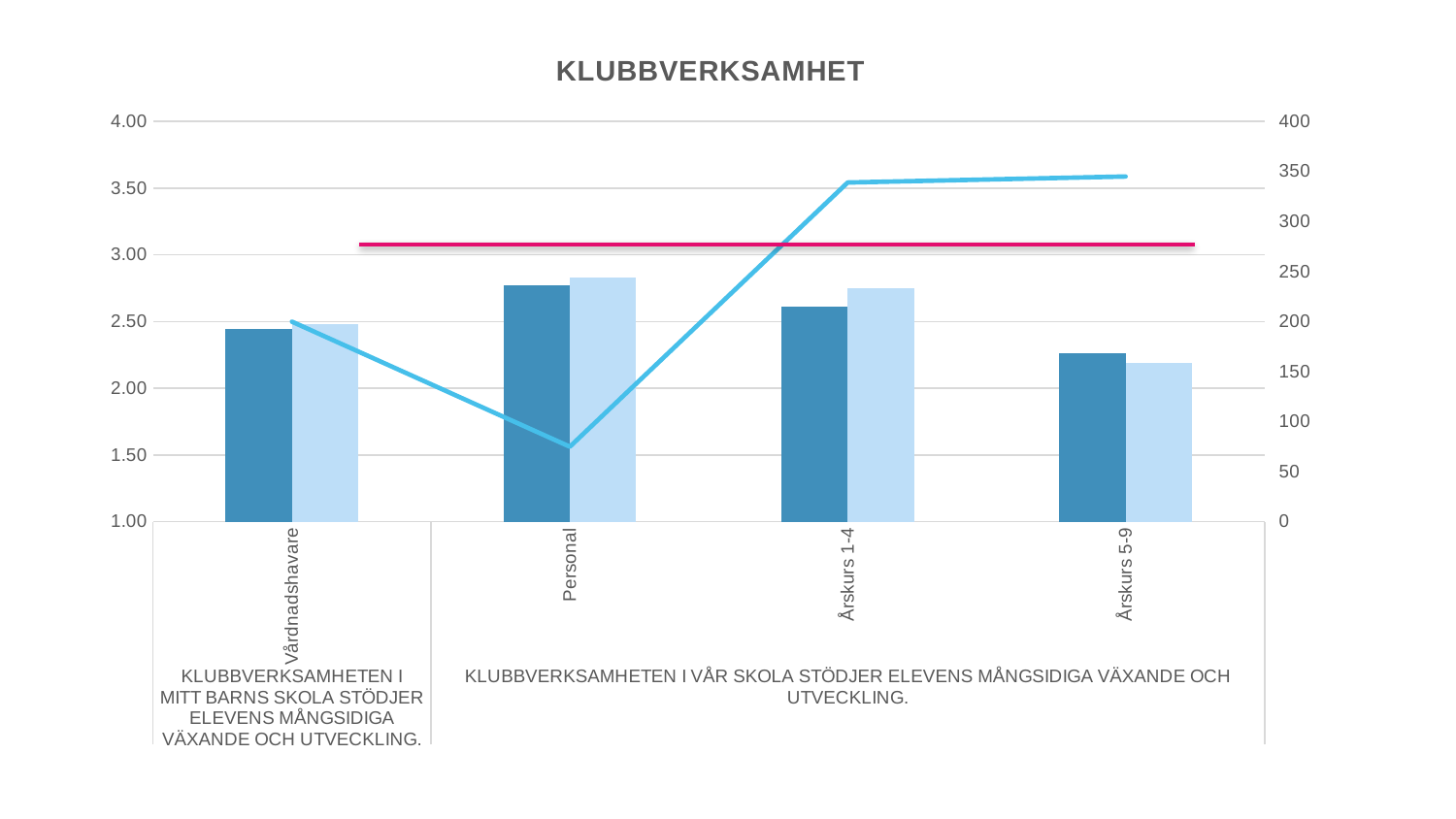
Is the light blue bar for Årskurs 1-4 greater or less than 2.50 on the left axis? greater What is the title of the chart? KLUBBVERKSAMHET Which category has the shortest dark blue bar? Årskurs 5-9 Which is larger, the dark blue bar for Personal or the dark blue bar for Årskurs 1-4? Personal Is the dark blue bar for Årskurs 5-9 greater or less than 2.50 on the left axis? less Is the light blue line at Årskurs 1-4 greater or less than 300 on the right axis? greater Which category has the shortest light blue bar? Årskurs 5-9 What kind of chart is shown on the slide? bar chart with a line At which category does the light blue line reach its lowest point? Personal How many categories are shown on the x axis of the chart? 4 Which category has the tallest dark blue bar? Personal